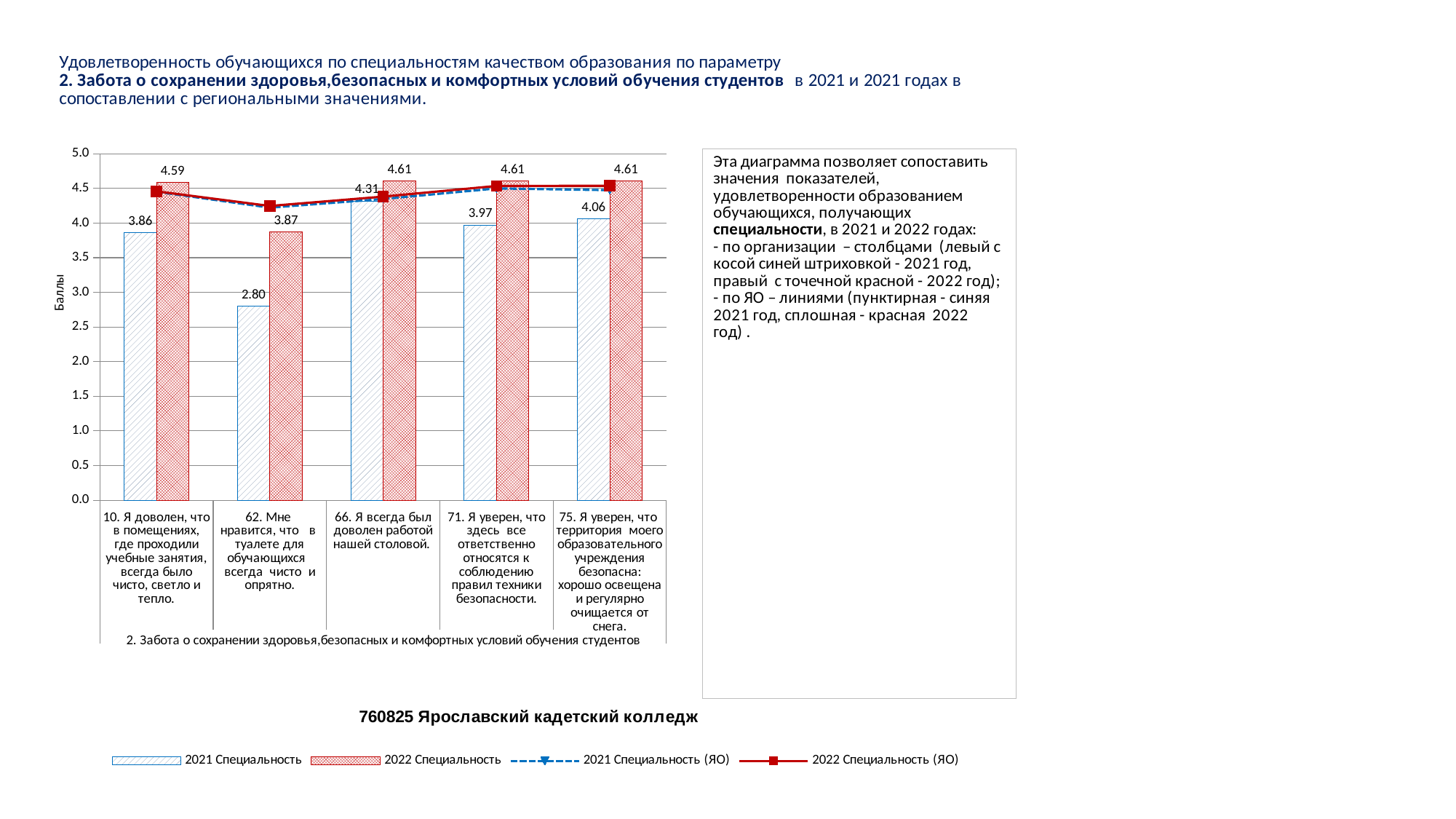
Which is larger for question 75: the 2021 Специальность value or the 2022 Специальность value? 2022 Специальность What is the 2021 Специальность value for question 62 (Мне нравится, что в туалете для обучающихся всегда чисто и опрятно)? 2.80 Which question has the lowest 2022 Специальность value? 62. Мне нравится, что в туалете для обучающихся всегда чисто и опрятно. What is the difference between the 2022 and 2021 Специальность values for question 62? 1.07 Which question has the lowest 2021 Специальность value? 62. Мне нравится, что в туалете для обучающихся всегда чисто и опрятно. How many questions (categories) are shown on the x axis? 5 What is the 2021 Специальность value for question 66 (Я всегда был доволен работой нашей столовой)? 4.31 What kind of chart is shown on the slide? Combined bar and line chart Is the 2021 Специальность value for question 71 greater or less than 4.0? less How many series does the legend list? 4 What is the 2022 Специальность value for question 10 (Я доволен, что в помещениях, где проходили учебные занятия, всегда было чисто, светло и тепло)? 4.59 What is the label of the y axis? Баллы